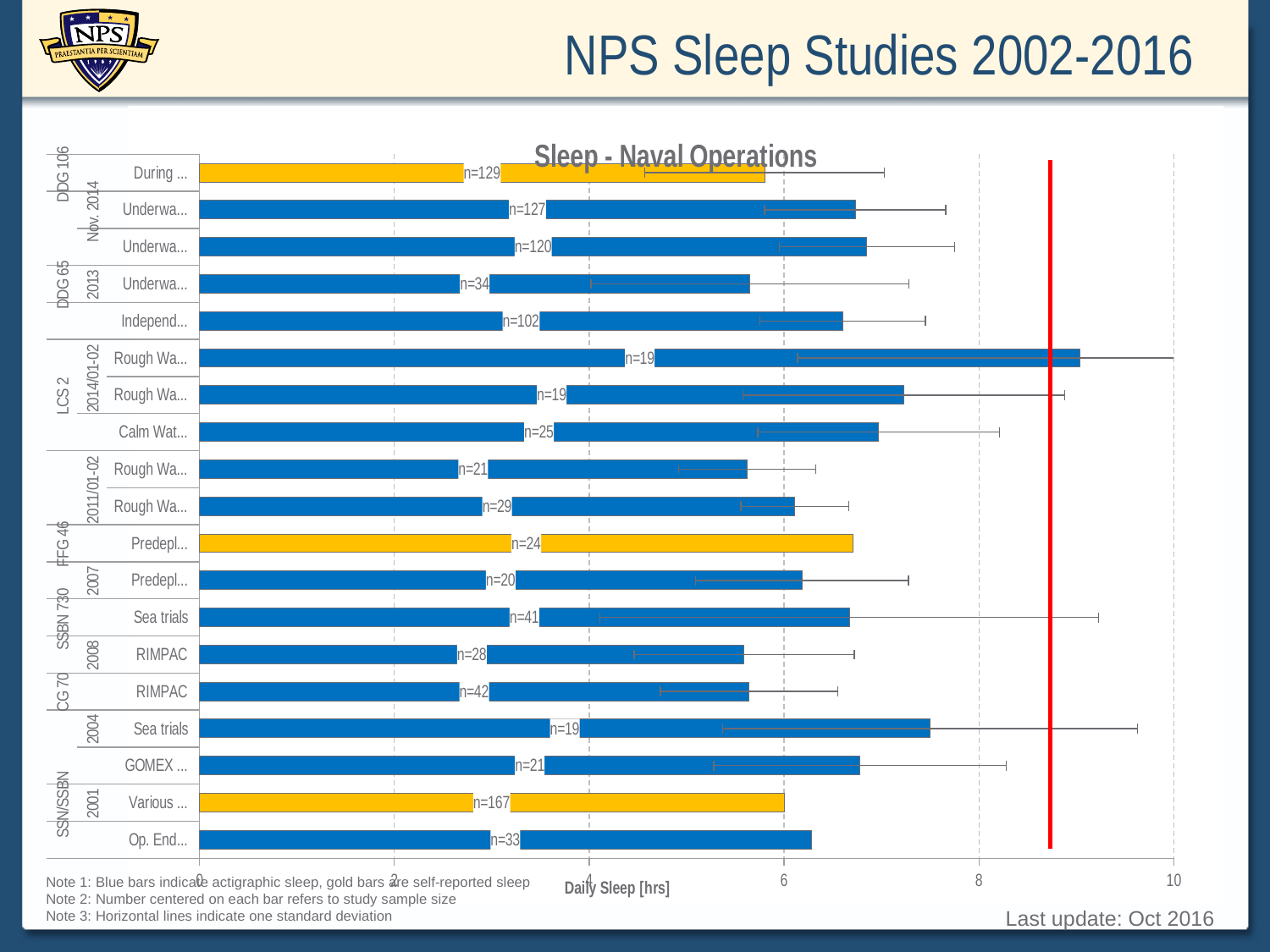
Is the daily sleep value for the 'During ...' bar greater or less than 6? less What sample size is printed on the 'During ...' bar? n=129 What type of chart is shown on the slide? Bar chart How many bars are plotted in the chart? 19 What sample size is printed on the 'Op. End...' bar? n=33 What sample size is printed on the 'Various ...' bar? n=167 What is the title of the chart? Sleep - Naval Operations What is the label of the horizontal axis? Daily Sleep [hrs] Which has the larger daily sleep value, the 'Calm Wat...' bar or the 'During ...' bar? Calm Wat... Is the daily sleep value for the 'Calm Wat...' bar greater or less than 6? greater Which bar shows the highest daily sleep value? Rough Wa... (n=19, the upper one) What sample size is printed on the 'Independ...' bar? n=102